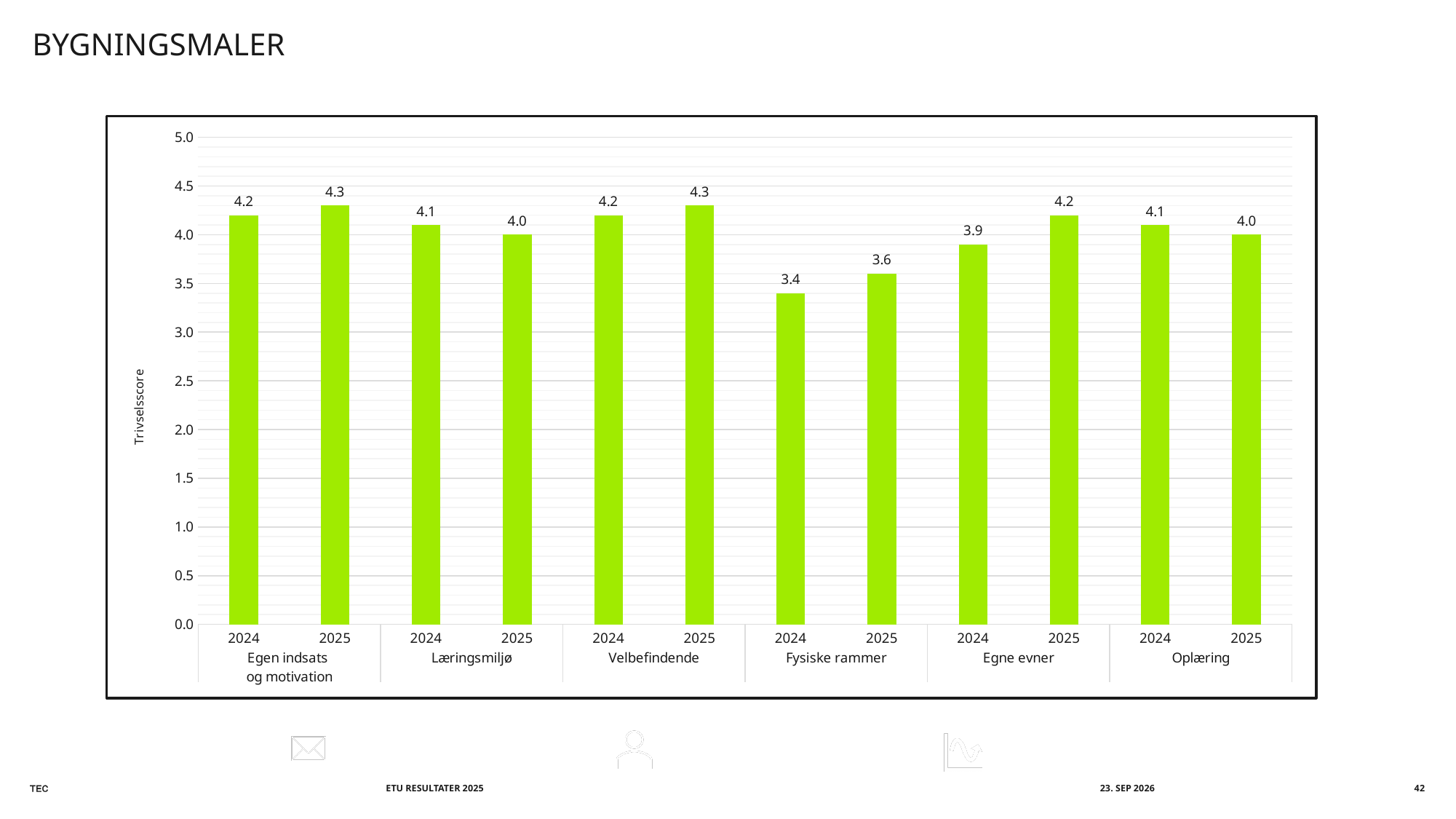
How many categories are shown on the x axis? 6 What is the value for Egne evner in 2025? 4.2 What is the difference between the 2025 and 2024 values for Egne evner? 0.3 Which category has the lowest value in 2024? Fysiske rammer What is the value for Oplæring in 2024? 4.1 What is the difference between the 2024 and 2025 values for Læringsmiljø? 0.1 What is the value for Egen indsats og motivation in 2025? 4.3 Which is larger, the 2024 value for Velbefindende or the 2025 value for Fysiske rammer? 2024 value for Velbefindende Is the value for Fysiske rammer in 2025 greater or less than 4.0? less What is the value for Fysiske rammer in 2024? 3.4 What kind of chart is shown on the slide? bar chart What is the label of the y axis? Trivselsscore